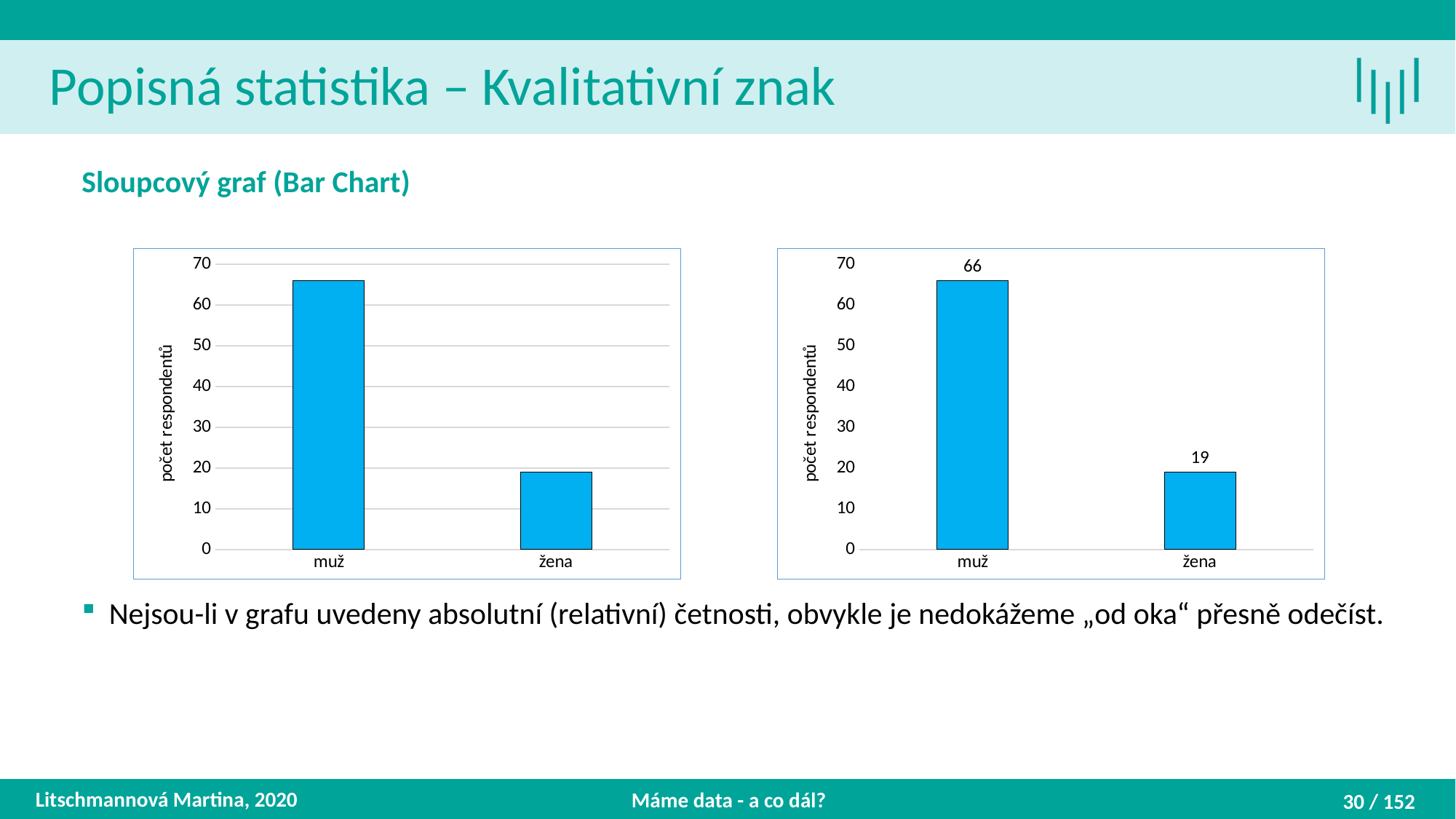
In the left chart, is the value for žena greater or less than 30? less In the right chart, what is the value for muž? 66 In the left chart, which is larger, the bar for muž or the bar for žena? muž What is the total of the two bars in the right chart? 85 In the right chart, what is the value for žena? 19 How many categories are shown on the x axis of the left chart? 2 What is the y-axis label of the left chart? počet respondentů In the right chart, which category has the highest value? muž In the left chart, is the value for muž greater or less than 60? greater In the left chart, which category has the lowest value? žena In the right chart, what is the difference between the values for muž and žena? 47 What kind of chart is shown on the right side of the slide? bar chart